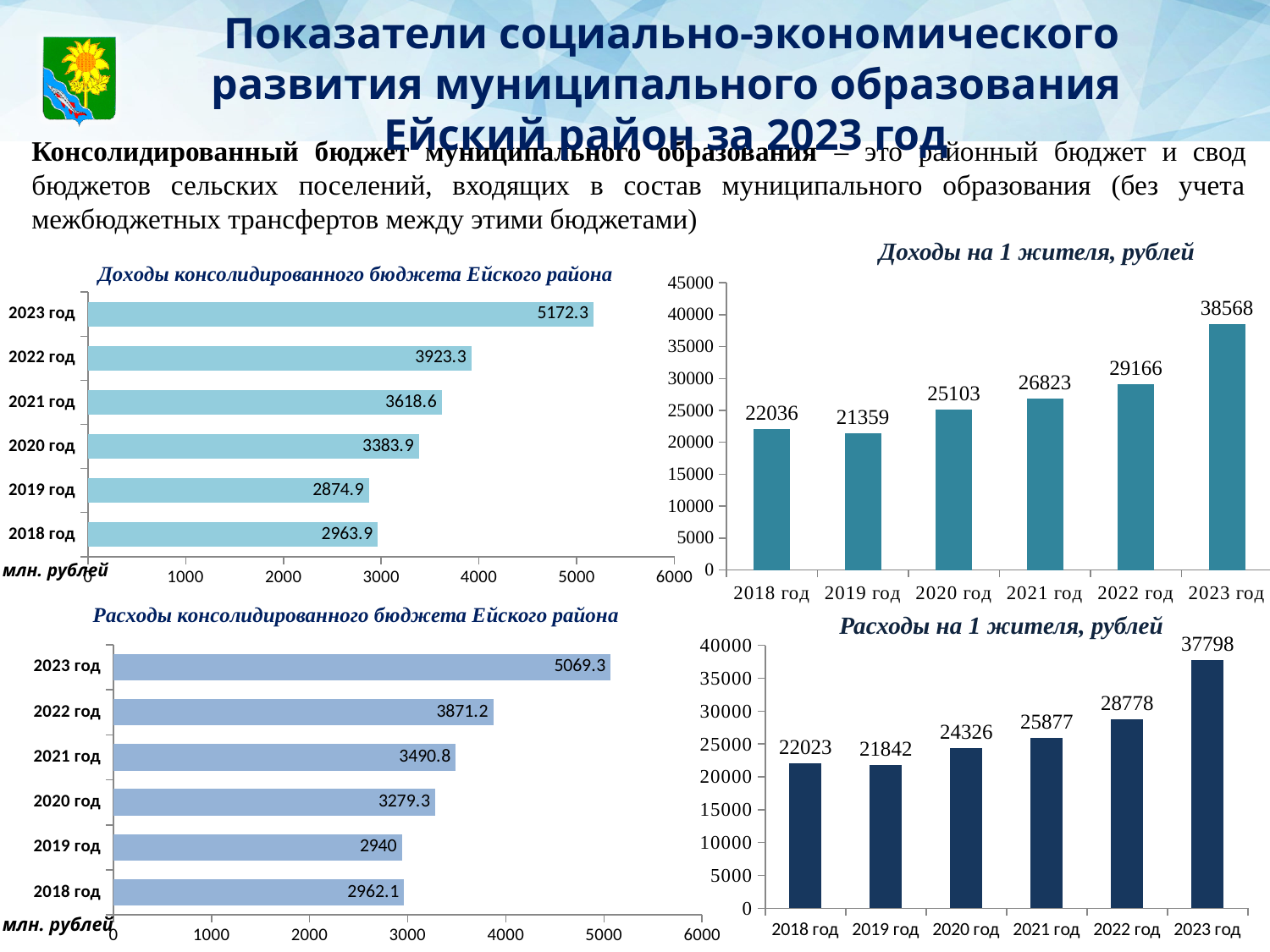
In the chart 'Доходы на 1 жителя, рублей', what is the value for 2020 год? 25103 In the chart 'Расходы на 1 жителя, рублей', what is the difference between the values for 2023 год and 2022 год? 9020 In the chart 'Доходы консолидированного бюджета Ейского района', what is the value for 2023 год? 5172.3 In the chart 'Доходы консолидированного бюджета Ейского района', which year has the lowest value? 2019 год In the chart 'Расходы на 1 жителя, рублей', is the value for 2023 год greater or less than 35000? greater In the chart 'Доходы консолидированного бюджета Ейского района', what is the difference between the values for 2023 год and 2022 год? 1249 What kind of chart is 'Расходы консолидированного бюджета Ейского района'? Bar chart In the chart 'Расходы на 1 жителя, рублей', what is the value for 2022 год? 28778 In the chart 'Расходы консолидированного бюджета Ейского района', what is the value for 2019 год? 2940 In the chart 'Доходы на 1 жителя, рублей', how many years are shown? 6 In the chart 'Доходы на 1 жителя, рублей', which year has the highest value? 2023 год In the chart 'Расходы консолидированного бюджета Ейского района', which is larger, the value for 2018 год or 2019 год? 2018 год